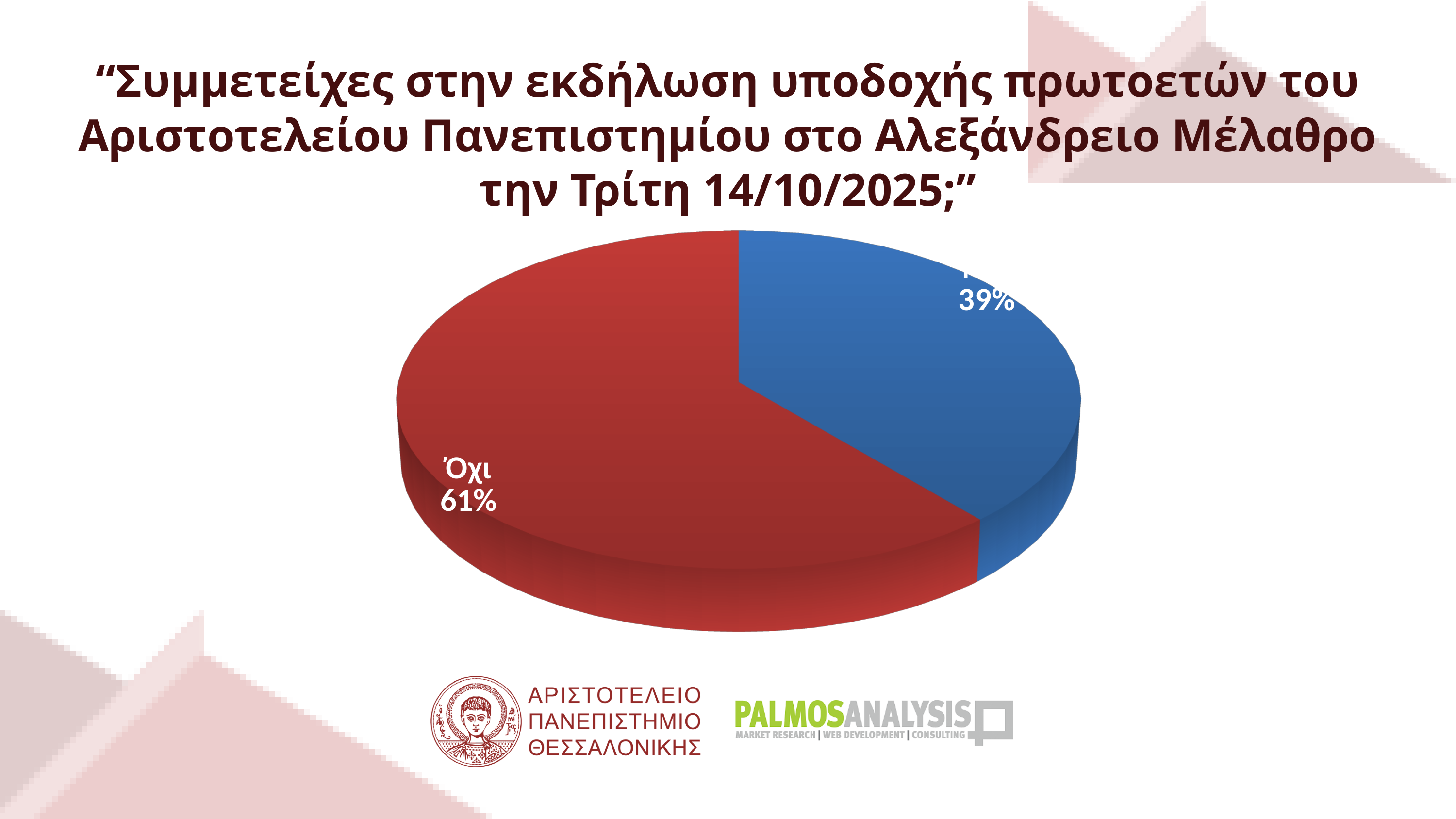
What percentage is shown on the blue slice of the pie chart? 39% Which is larger, the "Όχι" slice or the blue slice? Όχι Is the share of the "Όχι" slice greater or less than 50%? greater What kind of chart is shown on the slide? pie chart What colour is the "Όχι" slice of the pie chart? red What is the difference in percentage points between the "Όχι" slice and the blue slice? 22 Which slice of the pie chart is the largest? Όχι What share of the pie does the "Όχι" slice represent? 61% How many slices does the pie chart have? 2 What is the total of the two percentages shown on the pie chart? 100%